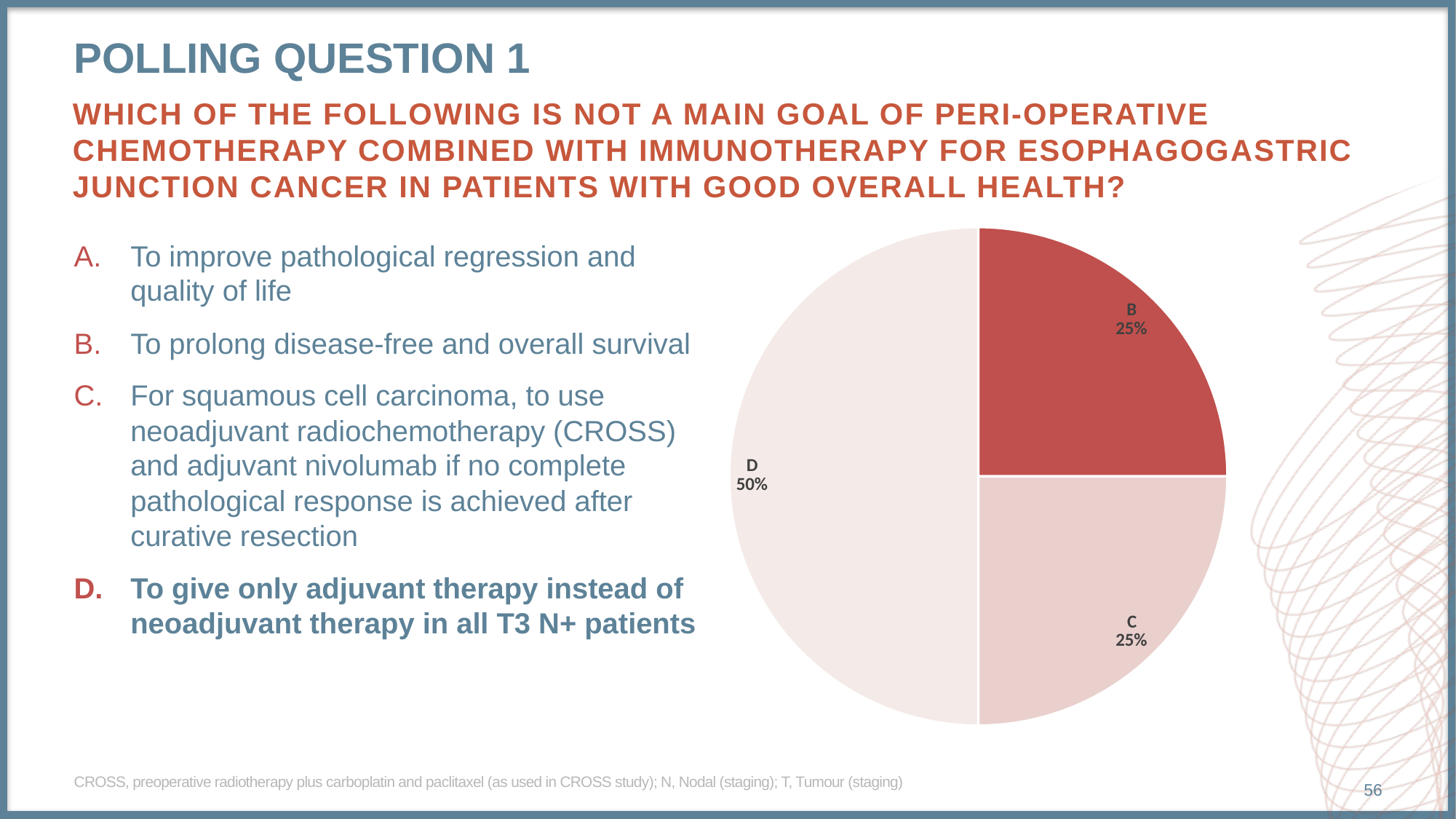
What share of the pie does slice C represent? 25% What kind of chart is shown on the slide? pie chart Is the share for D greater or less than 40%? greater Which is larger, the share for D or the share for C? D Which answer option is not represented by a slice in the pie chart? A Which slice of the pie chart is coloured dark red? B What is the difference between the share for D and the share for B? 25% What share of the pie does slice B represent? 25% How many slices does the pie chart have? 3 What share of the pie does slice D represent? 50% Which slice of the pie chart is the largest? D